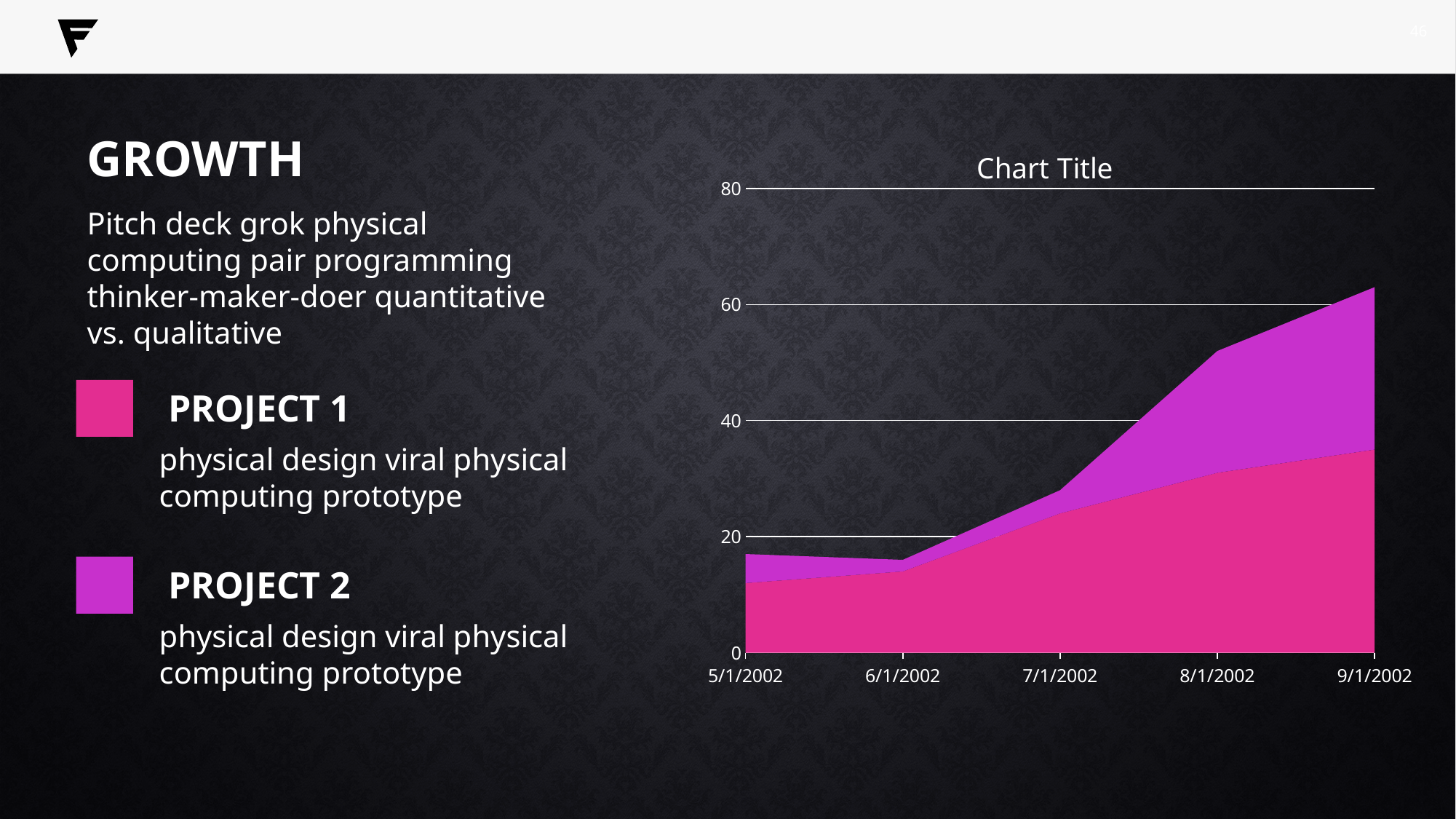
Is the stacked total at 8/1/2002 greater or less than 40? greater Do the stacked values generally rise or fall from 5/1/2002 to 9/1/2002? rise How many dates are plotted along the x axis of the chart? 5 Is the value of the bottom (pink) series at 9/1/2002 greater or less than 40? less Is the stacked total at 9/1/2002 greater or less than 60? greater Which date has the highest stacked total in the chart? 9/1/2002 Which is larger, the stacked total at 8/1/2002 or at 7/1/2002? 8/1/2002 What is the title of the chart? Chart Title How many data series are stacked in the chart? 2 What kind of chart is shown on the slide? area chart